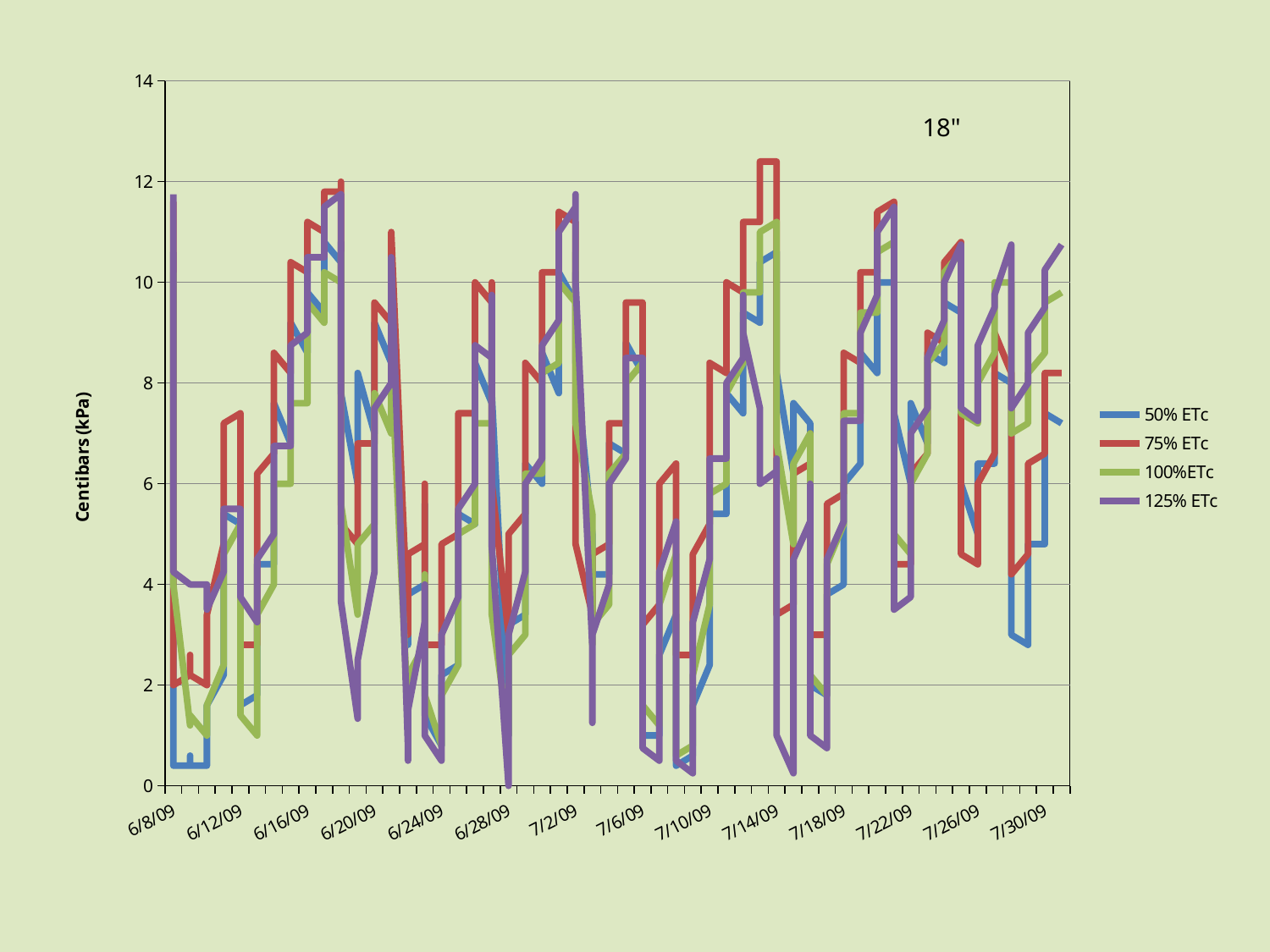
What is the title of the vertical axis? Centibars (kPa) What is the first date label on the horizontal axis? 6/8/09 How many series does the legend list? 4 Is the starting value of the 125% ETc series at 6/8/09 greater or less than 10? greater Is the lowest value of the 125% ETc series, near 6/28/09, greater or less than 2? less How many date labels are shown on the horizontal axis? 14 What is the last date label on the horizontal axis? 7/30/09 Which series reaches the highest value on the chart, near 7/14/09? 75% ETc What text annotation appears in the upper right of the plot area? 18" What kind of chart is shown on the slide? line chart Is the highest peak of the 75% ETc series, near 7/14/09, greater or less than 12? greater What is the highest value shown on the vertical axis? 14